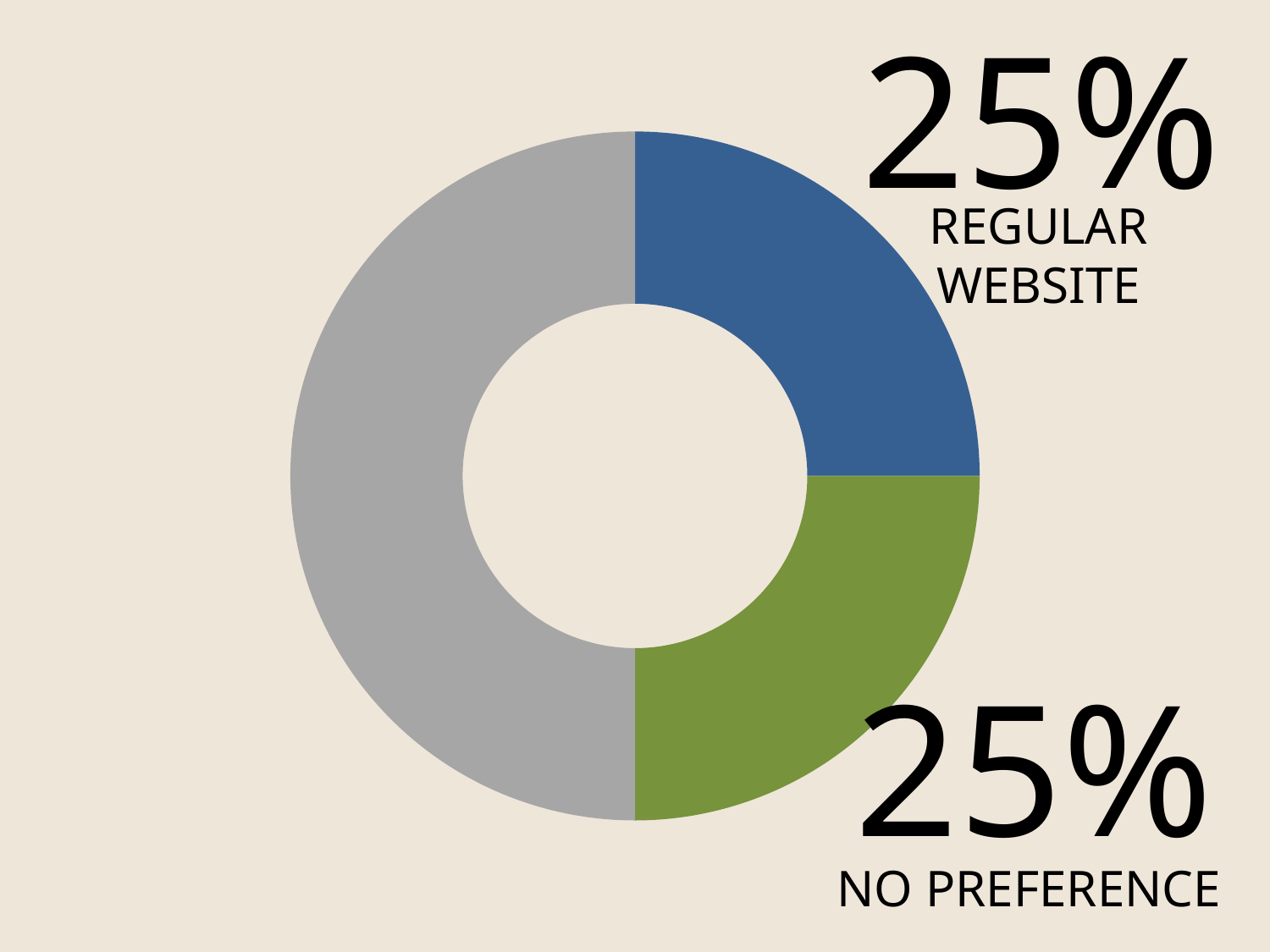
What percentage of the pie chart is labelled Regular Website? 25% Which is larger, the Regular Website share or the No Preference share? They are equal How many slices does the pie chart have? 3 What is the difference between the Regular Website share and the No Preference share? 0% What is the combined share of the Regular Website and No Preference slices? 50% What kind of chart is shown on the slide? pie chart (donut) What colour is the Regular Website slice? Blue Which colour slice is the largest in the pie chart? Gray What percentage of the pie chart is labelled No Preference? 25%